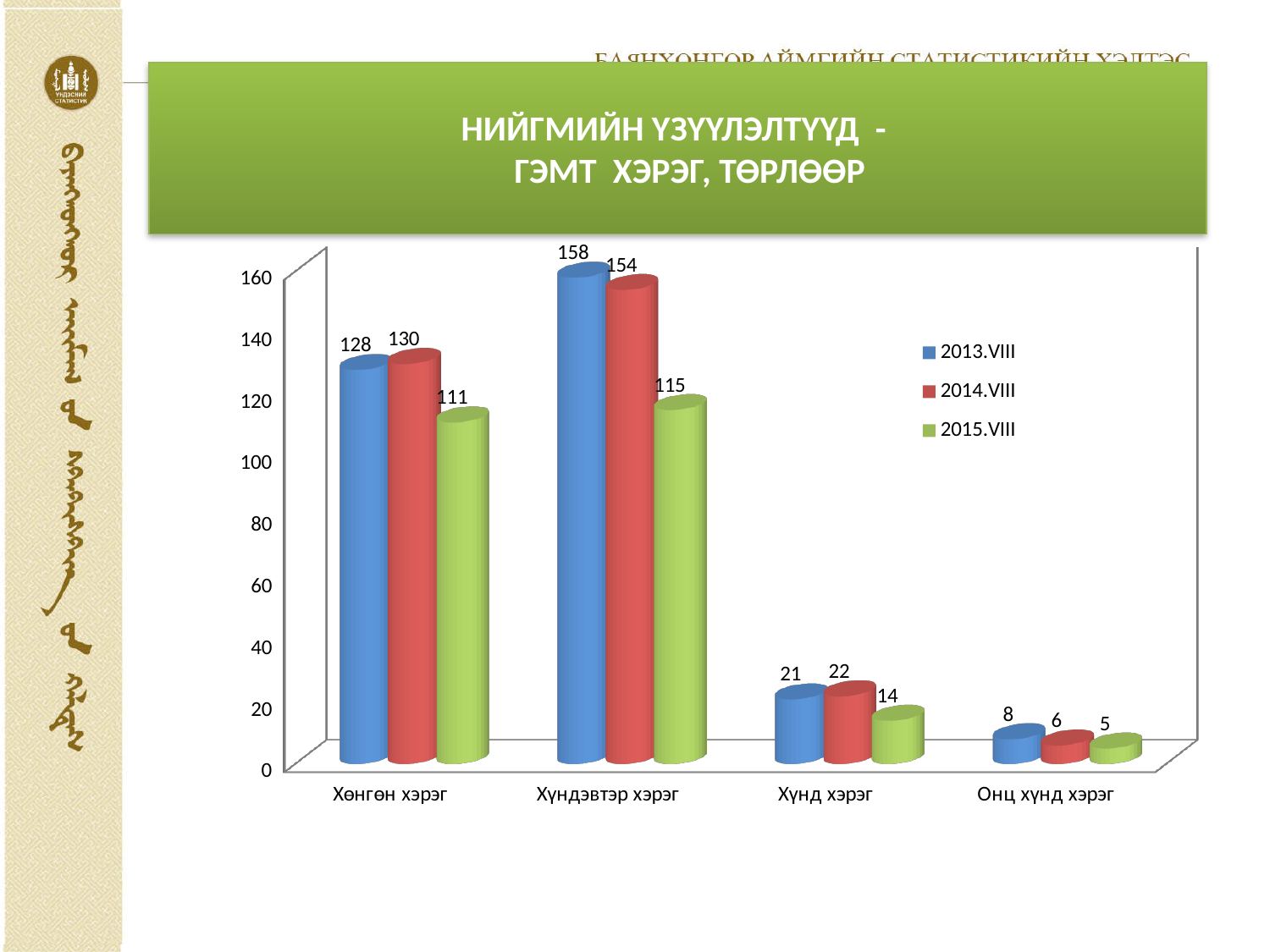
How many series does the legend list? 3 Which colour represents the 2015.VIII series? green What is the value for Онц хүнд хэрэг in the 2014.VIII series? 6 What is the value for Хөнгөн хэрэг in the 2015.VIII series? 111 Which is larger for Хөнгөн хэрэг: the 2013.VIII value or the 2014.VIII value? 2014.VIII What is the difference between the 2013.VIII and 2015.VIII values for Хүндэвтэр хэрэг? 43 What kind of chart is shown on the slide? bar chart Which category has the highest value in the 2014.VIII series? Хүндэвтэр хэрэг Which category has the lowest value in the 2015.VIII series? Онц хүнд хэрэг How many categories are shown on the x axis? 4 What is the value for Хүндэвтэр хэрэг in the 2013.VIII series? 158 Is the 2015.VIII value for Хүнд хэрэг greater or less than 20? less